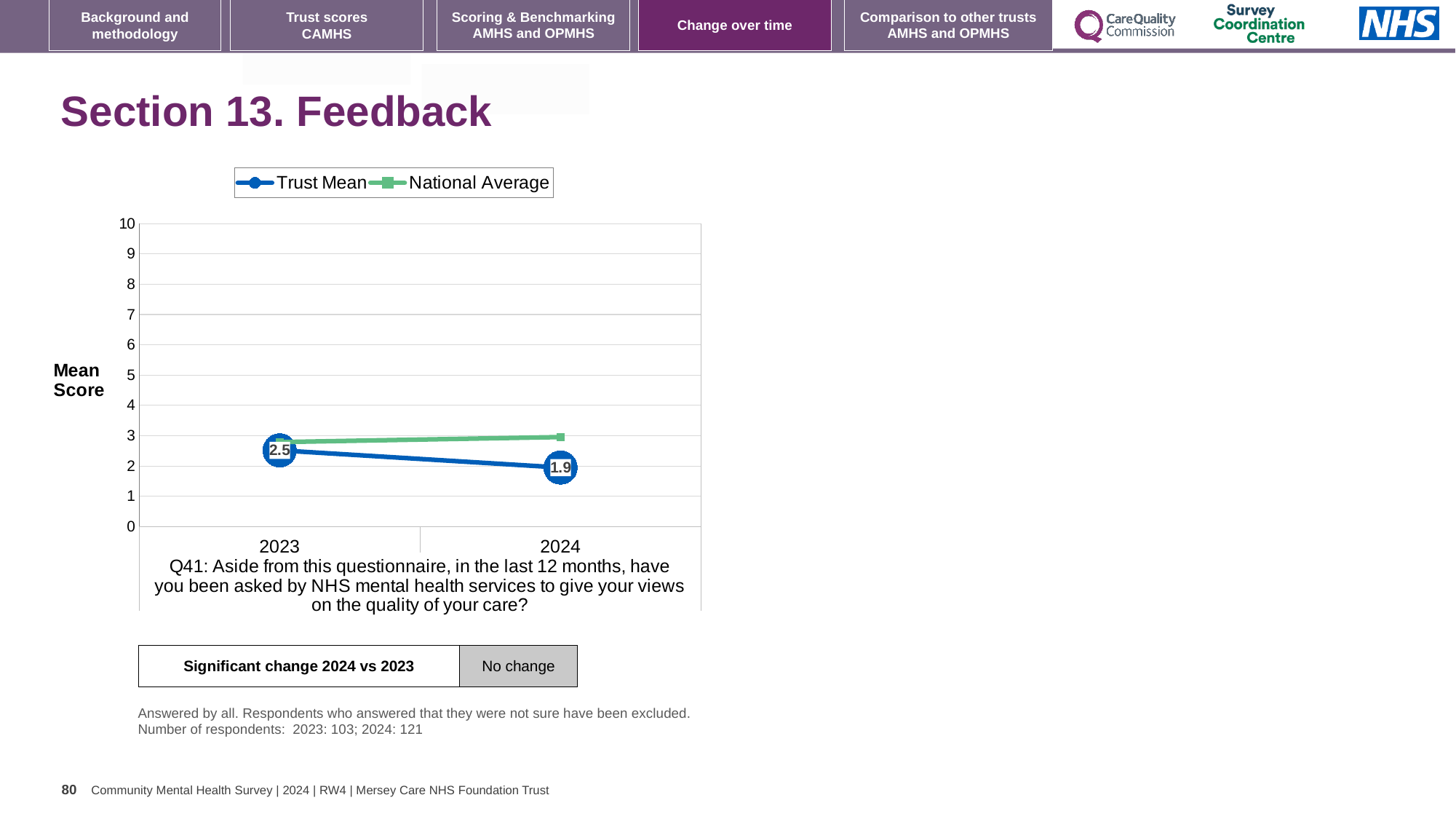
What kind of chart is shown on the slide? line chart How many series does the legend list? 2 What is the label of the y axis? Mean Score Which year has the higher Trust Mean score, 2023 or 2024? 2023 In 2024, which series has the higher value, Trust Mean or National Average? National Average Does the Trust Mean rise or fall from 2023 to 2024? fall Is the National Average value for 2023 greater or less than 2? greater Is the Trust Mean value for 2024 greater or less than 2? less What is the Trust Mean score for 2023? 2.5 What is the difference between the Trust Mean scores for 2023 and 2024? 0.6 What is the Trust Mean score for 2024? 1.9 How many years are shown on the x axis? 2